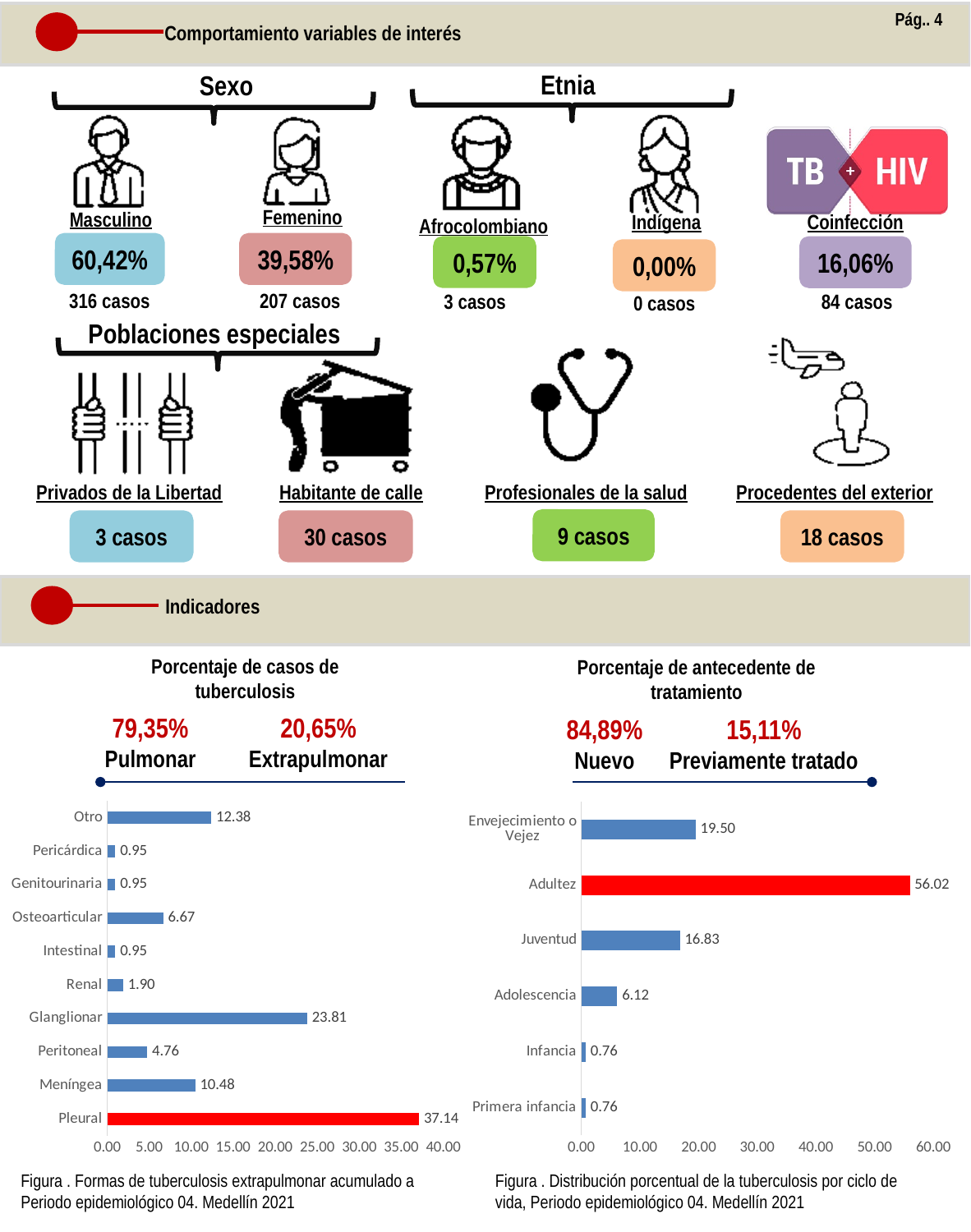
What kind of chart is the right chart (Distribución porcentual por ciclo de vida)? Bar chart In the left chart (Formas de tuberculosis extrapulmonar), what is the difference between the values for Pleural and Glanglionar? 13.33 In the left chart (Formas de tuberculosis extrapulmonar), which is larger, Otro or Osteoarticular? Otro In the right chart (Distribución porcentual por ciclo de vida), what is the difference between the values for Envejecimiento o Vejez and Juventud? 2.67 In the left chart (Formas de tuberculosis extrapulmonar), how many categories are shown? 10 In the right chart (Distribución porcentual por ciclo de vida), how many categories are shown? 6 In the right chart (Distribución porcentual por ciclo de vida), which category has the highest value? Adultez In the right chart (Distribución porcentual por ciclo de vida), which bar is coloured red? Adultez In the right chart (Distribución porcentual por ciclo de vida), what is the value for Adultez? 56.02 In the left chart (Formas de tuberculosis extrapulmonar), what is the value for Glanglionar? 23.81 In the left chart (Formas de tuberculosis extrapulmonar), which category has the highest value? Pleural In the left chart (Formas de tuberculosis extrapulmonar), what is the value for Meníngea? 10.48